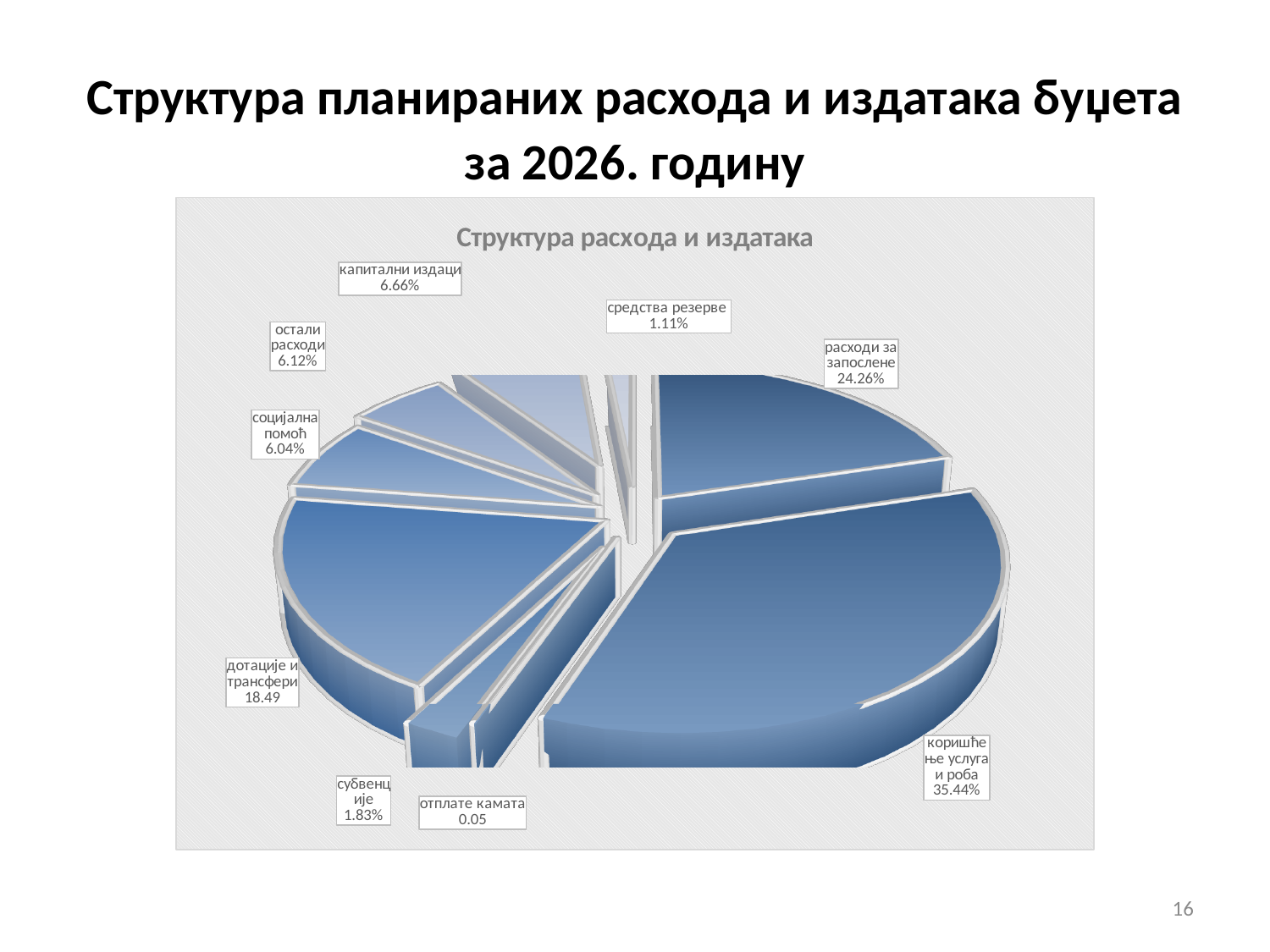
What kind of chart is shown on the slide? pie chart What value is shown for средства резерве? 1.11% What value is shown for расходи за запослене? 24.26% What is the title of the chart? Структура расхода и издатака Which category has the smallest slice of the pie? отплате камата What value is shown for капитални издаци? 6.66% How many slices does the pie chart have? 9 Which category has the largest slice of the pie? коришћење услуга и роба What value is shown for дотације и трансфери? 18.49 What share of the pie is labelled for коришћење услуга и роба? 35.44% What is the difference between the values for коришћење услуга и роба and расходи за запослене? 11.18%